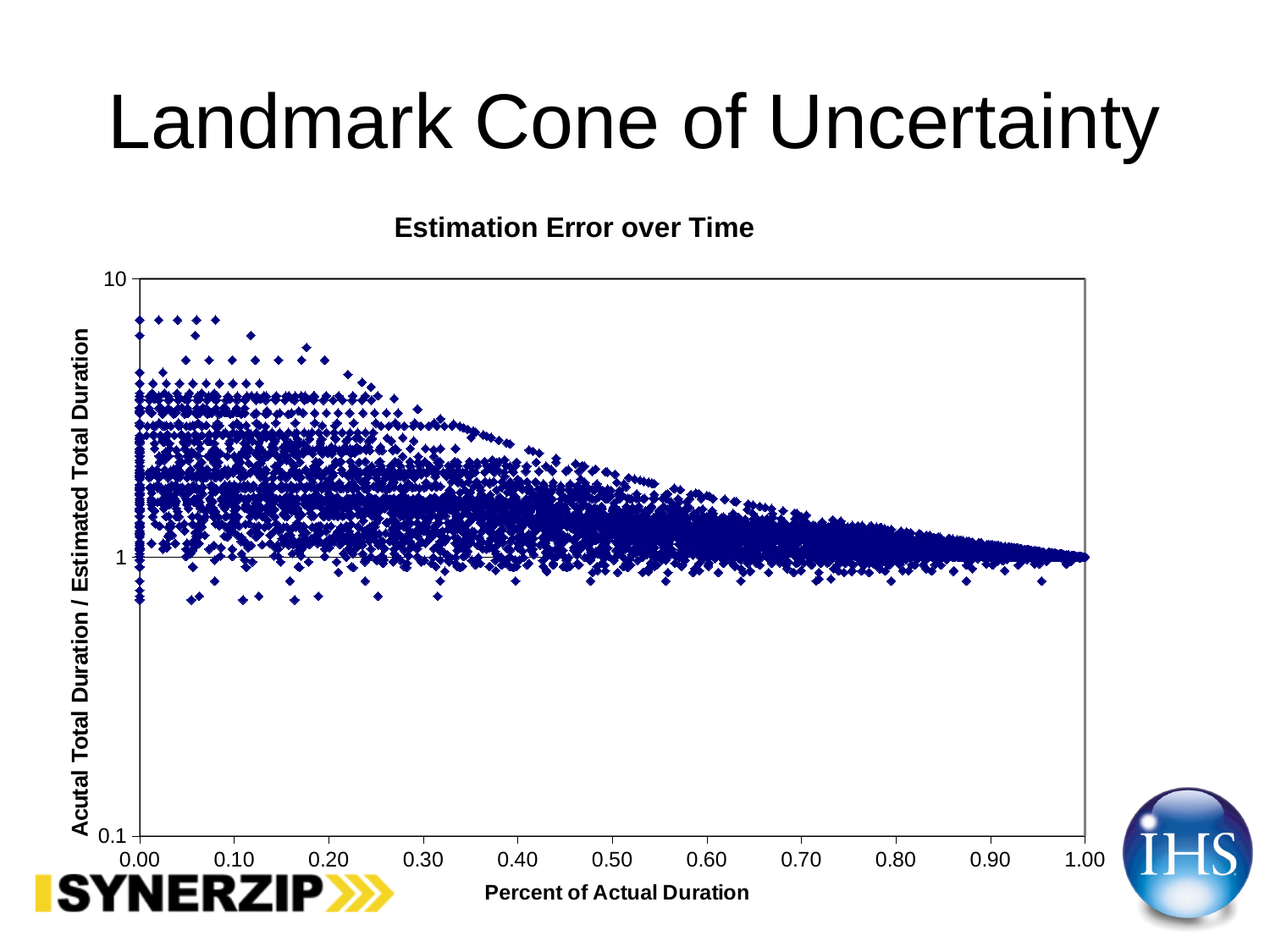
Is the vertical spread of points larger near 0.00 or near 1.00 on the horizontal axis? near 0.00 What is the highest tick value shown on the horizontal axis? 1.00 Are the points plotted at a Percent of Actual Duration of 1.00 greater or less than 10 on the vertical axis? less How many tick labels are shown on the horizontal axis? 11 What is the title of the chart? Estimation Error over Time As Percent of Actual Duration increases toward 1.00, does the spread of the plotted points widen or narrow? narrow Are the highest plotted points on the chart greater or less than 10 on the vertical axis? less Toward which value on the vertical axis do the points converge as Percent of Actual Duration approaches 1.00? 1 What kind of chart is shown on the slide? scatter chart What is the label on the vertical axis of the chart? Acutal Total Duration / Estimated Total Duration Are the lowest plotted points on the chart greater or less than 0.1 on the vertical axis? greater What is the highest tick value shown on the vertical axis? 10